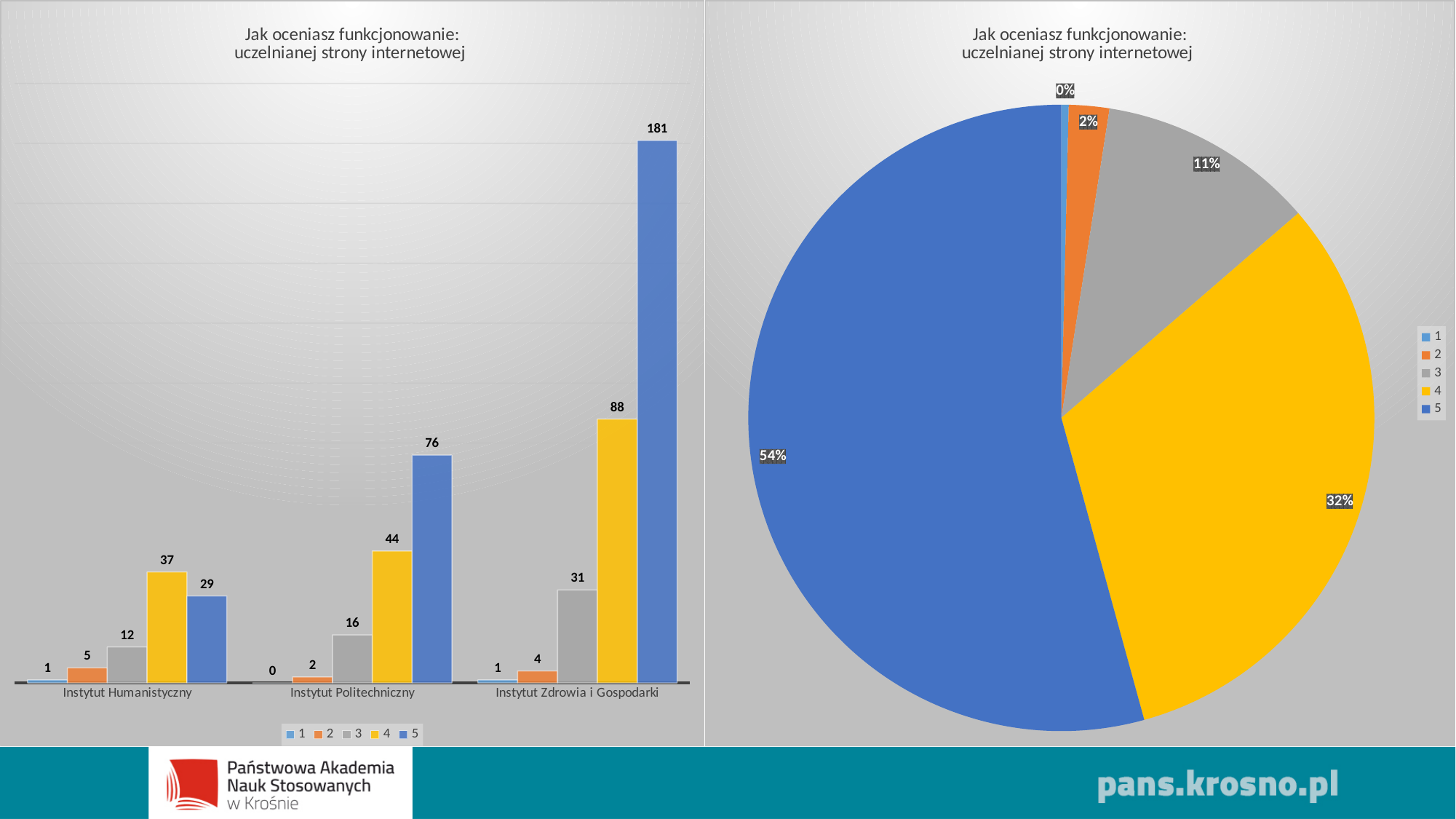
On the right pie chart, which category has the largest slice? 5 On the left bar chart, which is larger for Instytut Humanistyczny: series 4 or series 5? series 4 How many institutes are shown on the left bar chart? 3 On the left bar chart, what is the difference between series 5 and series 4 for Instytut Zdrowia i Gospodarki? 93 On the left bar chart, what is the value of series 3 for Instytut Politechniczny? 16 On the left bar chart, what is the value of series 4 for Instytut Humanistyczny? 37 How many series does the legend of the left bar chart list? 5 On the left bar chart, which institute has the lowest value for series 1? Instytut Politechniczny What type of chart is on the right side of the slide? pie chart On the right pie chart, what share does category 4 have? 32% On the left bar chart, which institute has the highest value for series 5? Instytut Zdrowia i Gospodarki On the left bar chart, what is the value of series 5 for Instytut Zdrowia i Gospodarki? 181